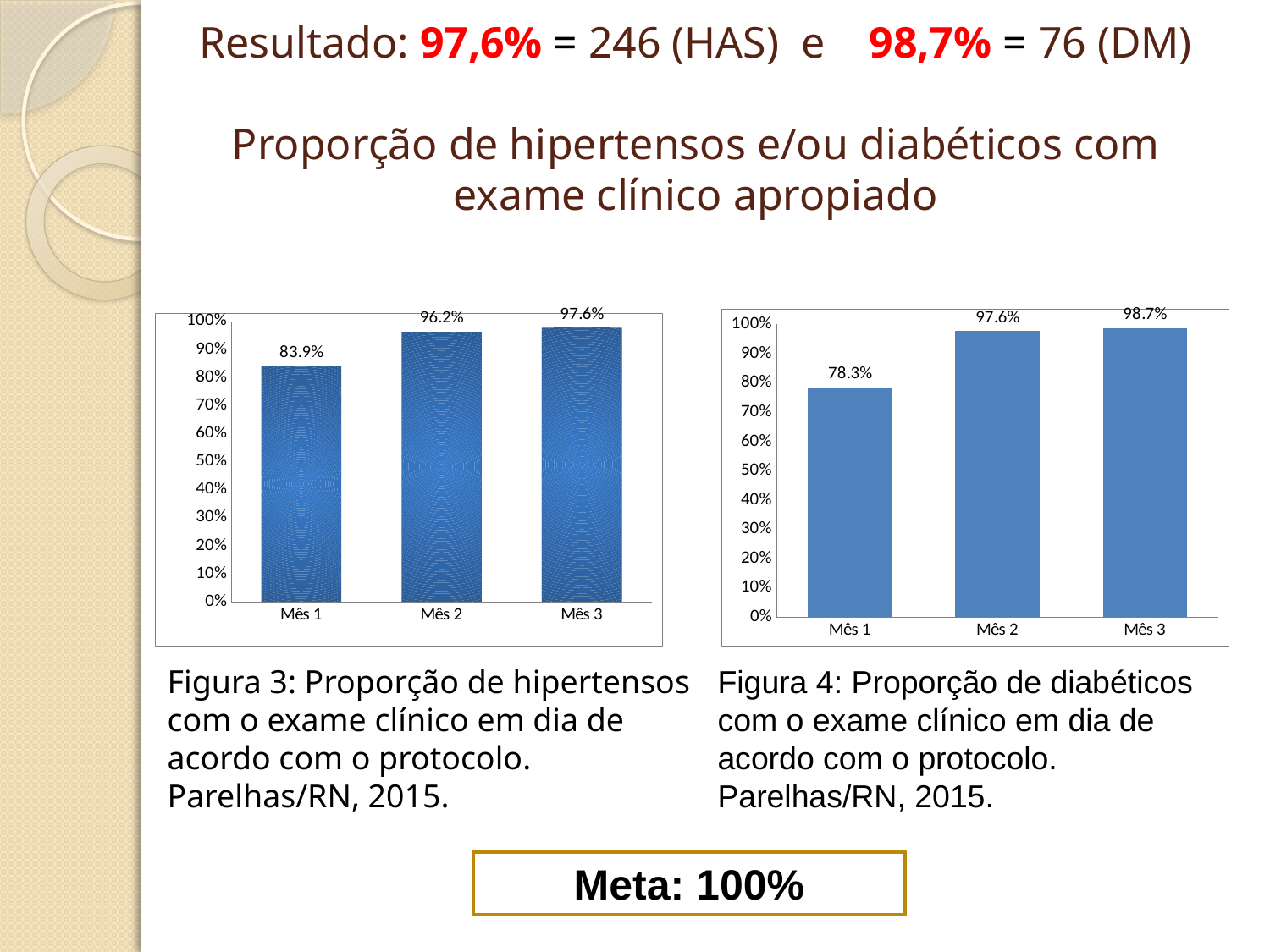
In the right chart (Figura 4, diabéticos), do the values rise or fall from Mês 1 to Mês 3? Rise Which is larger: the Mês 1 value in the left chart (hipertensos) or the Mês 1 value in the right chart (diabéticos)? Left chart (hipertensos), 83.9% In the left chart (Figura 3, hipertensos), what is the value for Mês 1? 83.9% In the left chart (Figura 3, hipertensos), which month has the lowest value? Mês 1 What kind of chart is the left chart (Figura 3, hipertensos)? Bar chart In the left chart (Figura 3, hipertensos), what is the difference between Mês 2 and Mês 1? 12.3% In the right chart (Figura 4, diabéticos), what is the value for Mês 2? 97.6% In the right chart (Figura 4, diabéticos), what is the value for Mês 1? 78.3% In the left chart (Figura 3, hipertensos), what is the value for Mês 3? 97.6% In the right chart (Figura 4, diabéticos), what is the difference between Mês 3 and Mês 1? 20.4% How many months (categories) are shown in the right chart (Figura 4, diabéticos)? 3 In the right chart (Figura 4, diabéticos), which month has the highest value? Mês 3